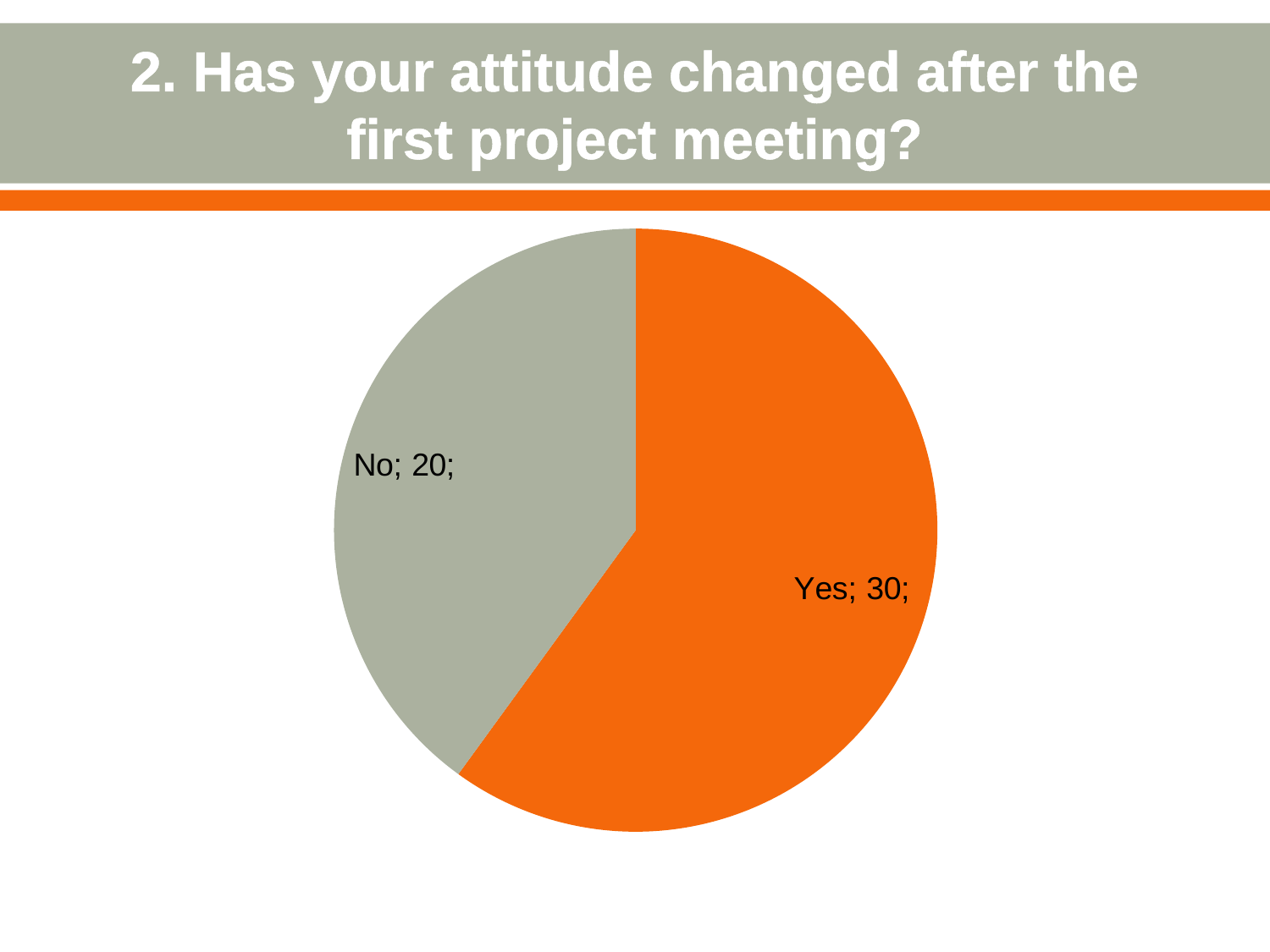
What is the value for No? 20 What is the difference between the values for Yes and No? 10 What share of the pie does the No slice represent? 40% What kind of chart is shown on the slide? pie chart What is the value for Yes? 30 What is the total of all slices in the pie chart? 50 Which category has the largest slice? Yes Which category has the smallest slice? No Which is larger, the value for Yes or the value for No? Yes What share of the pie does the Yes slice represent? 60% What colour is the Yes slice? orange How many slices does the pie chart have? 2